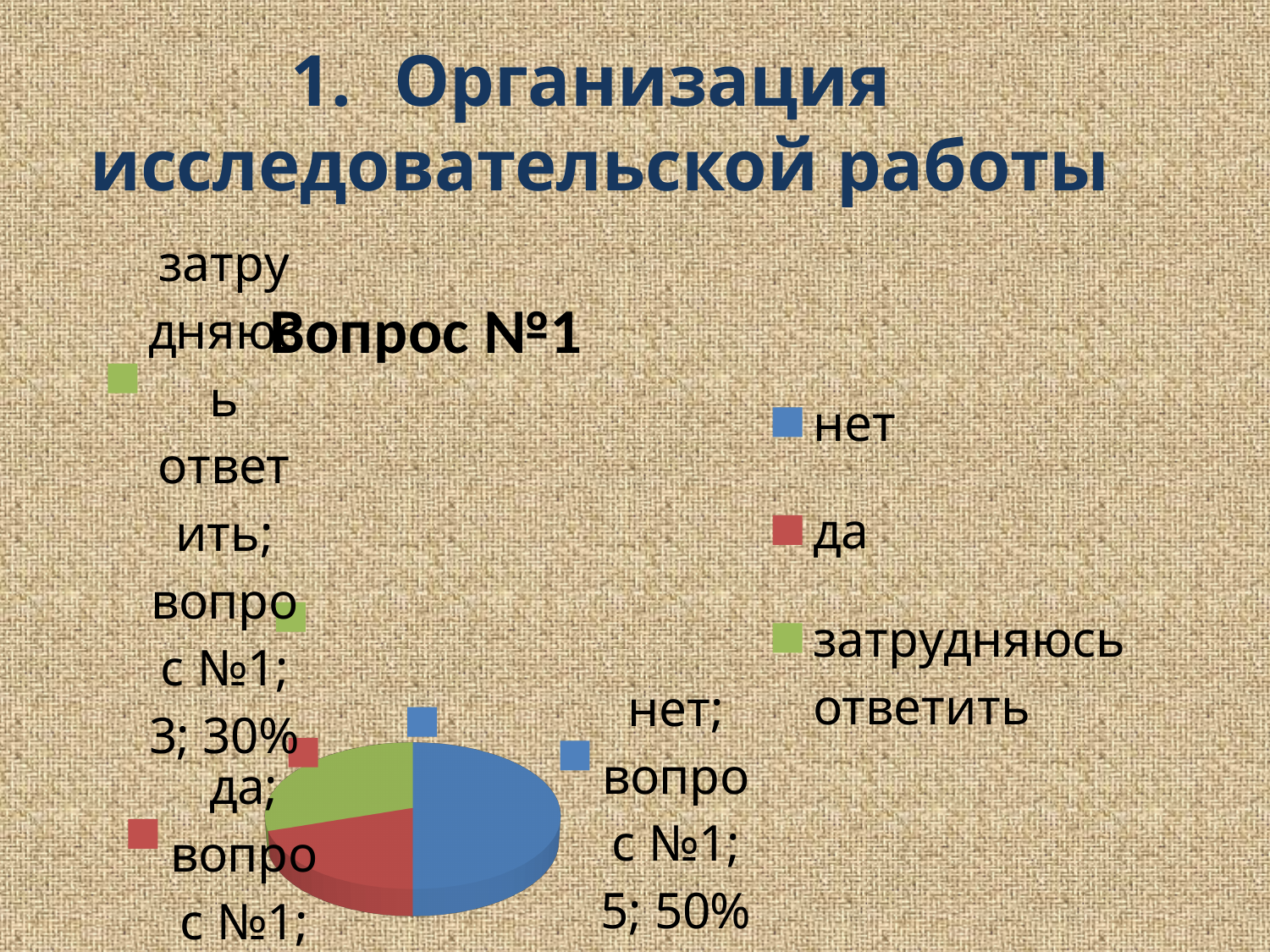
What is the value shown for the "нет" slice? 5 What is the value shown for the "затрудняюсь ответить" slice? 3 Which category has the smallest slice of the pie? да Which category has the largest slice of the pie? нет What share of the pie does the "затрудняюсь ответить" slice represent? 30% How many entries does the chart legend list? 3 Which is larger, the "нет" slice or the "затрудняюсь ответить" slice? нет What is the difference between the values for "нет" and "затрудняюсь ответить"? 2 What is the title of the chart? Вопрос №1 What share of the pie does the "нет" slice represent? 50% What kind of chart is shown on the slide? pie chart How many slices does the pie chart have? 3